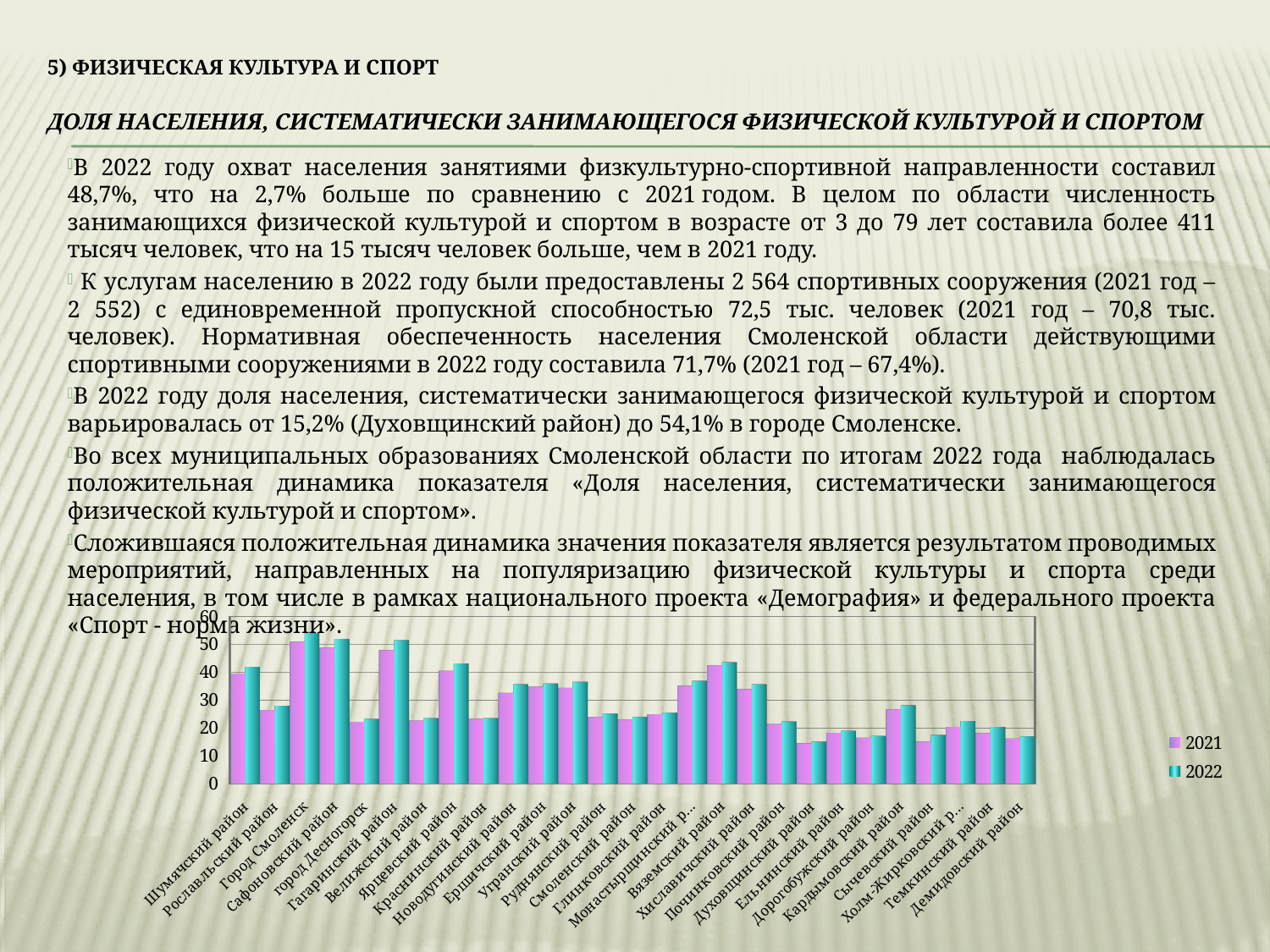
What kind of chart is shown on the slide? bar chart Which category has the lowest value for 2022 in the chart? Духовщинский район Is the 2022 value for Духовщинский район greater or less than 20? less How many series does the chart legend list? 2 Is the 2021 value for Хиславичский район greater or less than 40? less How many municipalities (categories) are shown on the x axis of the chart? 27 Is the 2022 value for Гагаринский район greater or less than 40? greater Which years are listed in the chart legend? 2021 and 2022 Which colour represents the 2022 series in the chart? teal (blue-green) Which category has the highest value for 2022 in the chart? город Смоленск Which has the larger 2022 value, город Смоленск or Велижский район? город Смоленск